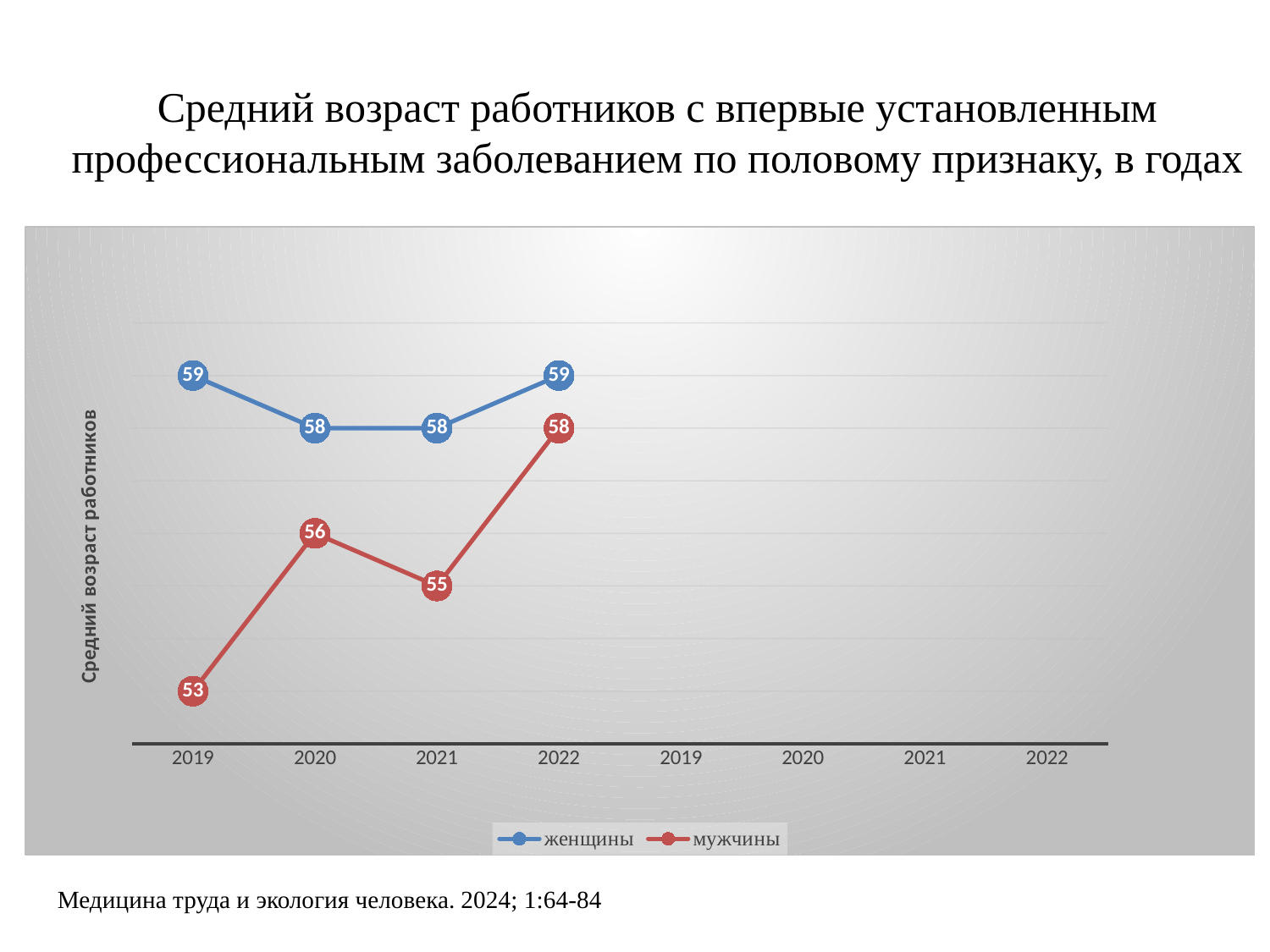
What is the value for женщины in 2019? 59 What is the value for мужчины in 2021? 55 What is the value for мужчины in 2022? 58 What is the difference between the женщины and мужчины values in 2019? 6 What is the difference between the мужчины values in 2022 and 2019? 5 Does the мужчины line rise or fall from 2019 to 2020? rise What is the value for женщины in 2020? 58 How many series does the legend list? 2 In which year is the value for мужчины highest? 2022 In which year is the value for мужчины lowest? 2019 What kind of chart is shown on the slide? line chart Which is larger in 2021, the value for женщины or for мужчины? женщины